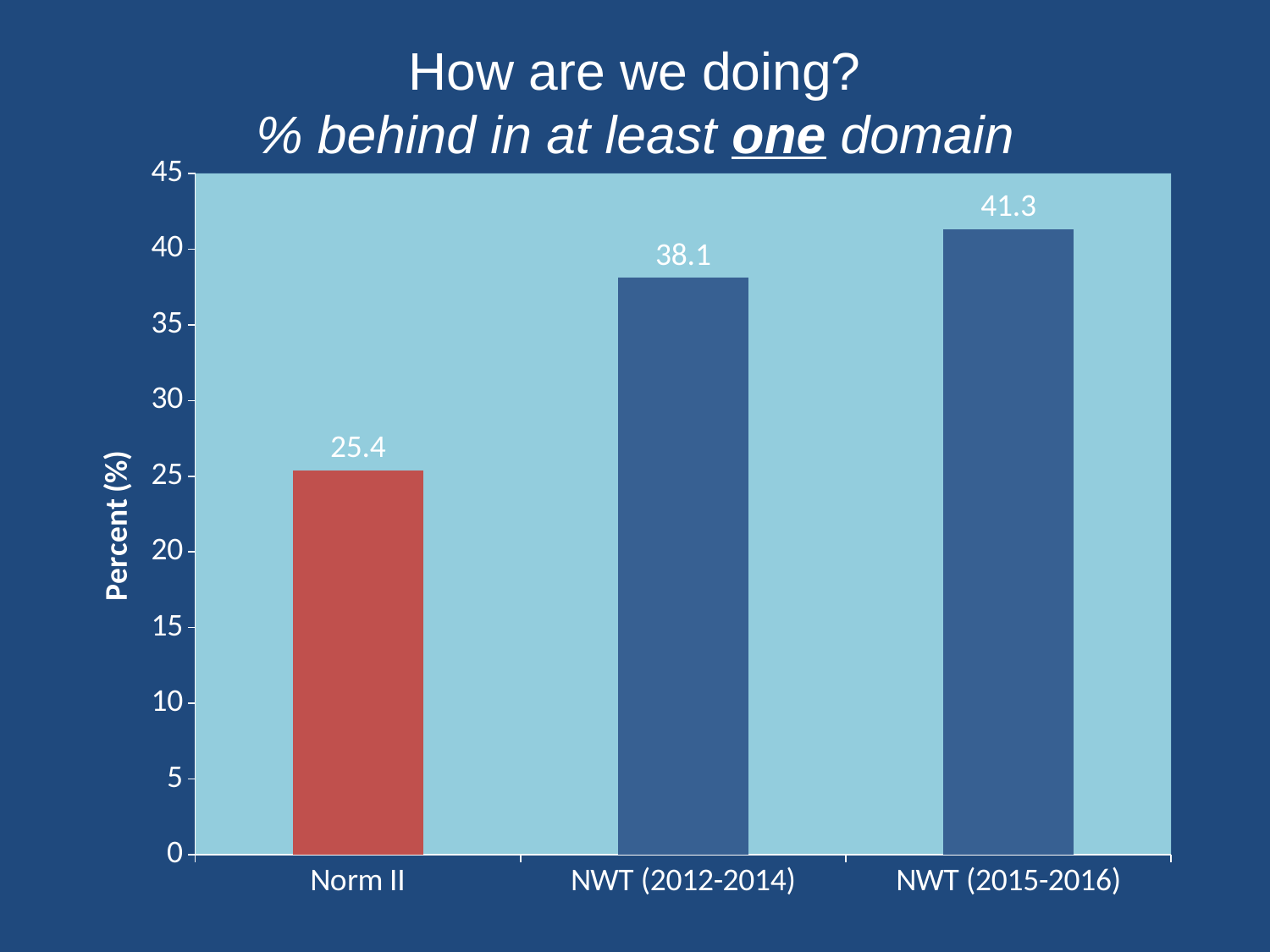
What is the value for NWT (2012-2014)? 38.1 Which category has the highest value? NWT (2015-2016) What is the value for Norm II? 25.4 What is the difference between the values for NWT (2015-2016) and Norm II? 15.9 What is the value for NWT (2015-2016)? 41.3 Is the value for NWT (2015-2016) greater or less than 40? greater What kind of chart is shown on the slide? bar chart What is the label of the y axis? Percent (%) What is the difference between the values for NWT (2015-2016) and NWT (2012-2014)? 3.2 How many categories are shown on the x axis? 3 Which category has the lowest value? Norm II Which is larger, the value for Norm II or the value for NWT (2012-2014)? NWT (2012-2014)